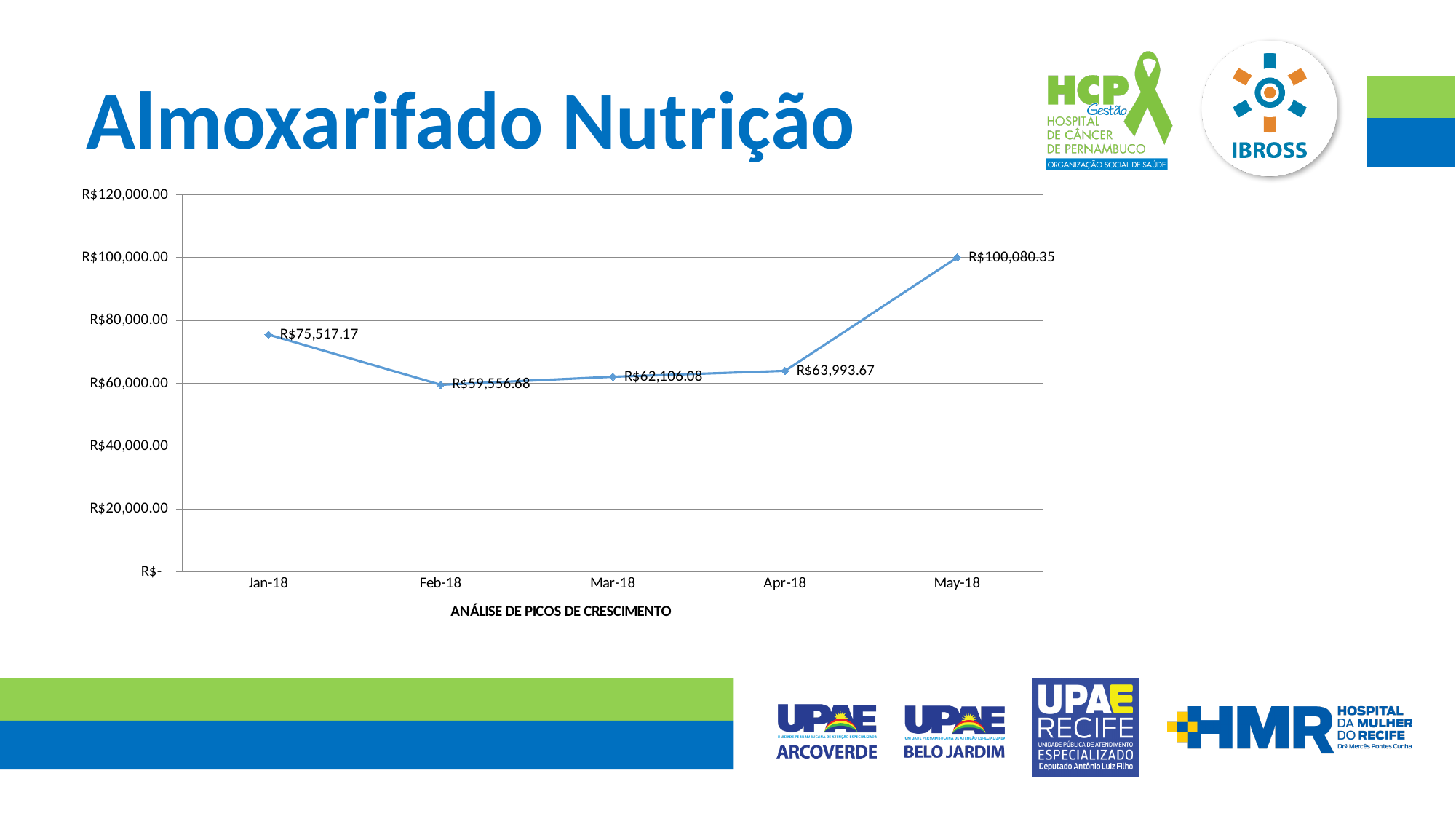
What is the value for Feb-18? R$59,556.68 What is the difference between the values for Jan-18 and Feb-18? R$15,960.49 What kind of chart is shown on the slide? Line chart Which is larger, the value for Mar-18 or the value for Apr-18? Apr-18 How many data points are plotted on the chart? 5 What is the label shown below the x axis of the chart? ANÁLISE DE PICOS DE CRESCIMENTO What is the value for Jan-18? R$75,517.17 Which month has the lowest value? Feb-18 What is the value for Mar-18? R$62,106.08 What is the difference between the values for May-18 and Apr-18? R$36,086.68 Which month has the highest value? May-18 What is the value for May-18? R$100,080.35